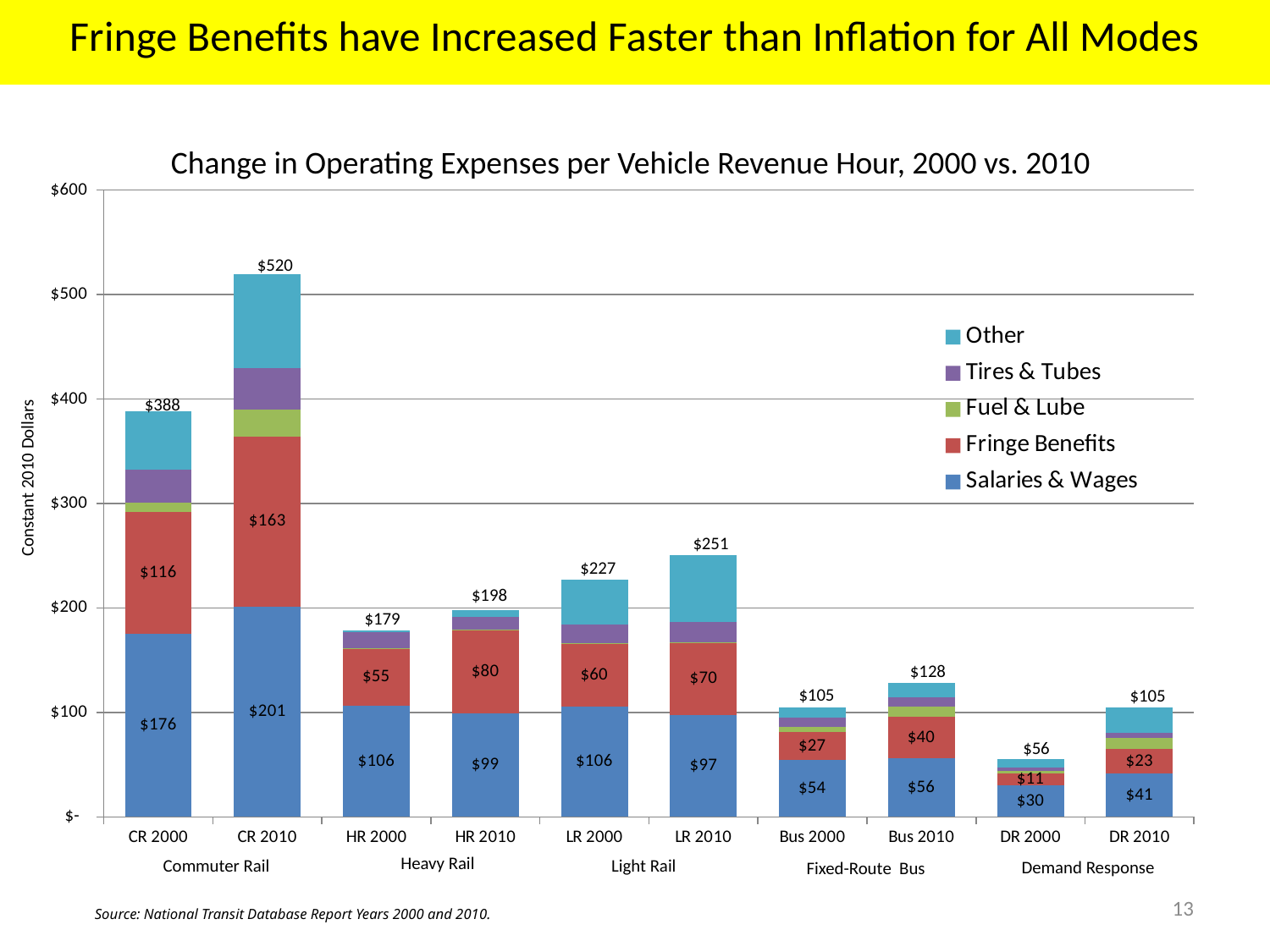
What kind of chart is shown on the slide? Stacked bar chart What is the Salaries & Wages value for HR 2010? $99 How many bars are shown in the chart? 10 What is the Fringe Benefits value for CR 2010? $163 Which bar has the lowest total operating expense per vehicle revenue hour? DR 2000 What is the Fringe Benefits value for DR 2000? $11 Which is larger, the Fringe Benefits value for Bus 2010 or for Bus 2000? Bus 2010 What is the difference between the total for CR 2010 and the total for CR 2000? $132 Which bar has the highest total operating expense per vehicle revenue hour? CR 2010 What is the difference in Fringe Benefits between HR 2010 and HR 2000? $25 What is the total operating expense per vehicle revenue hour for LR 2010? $251 How many series does the legend list? 5